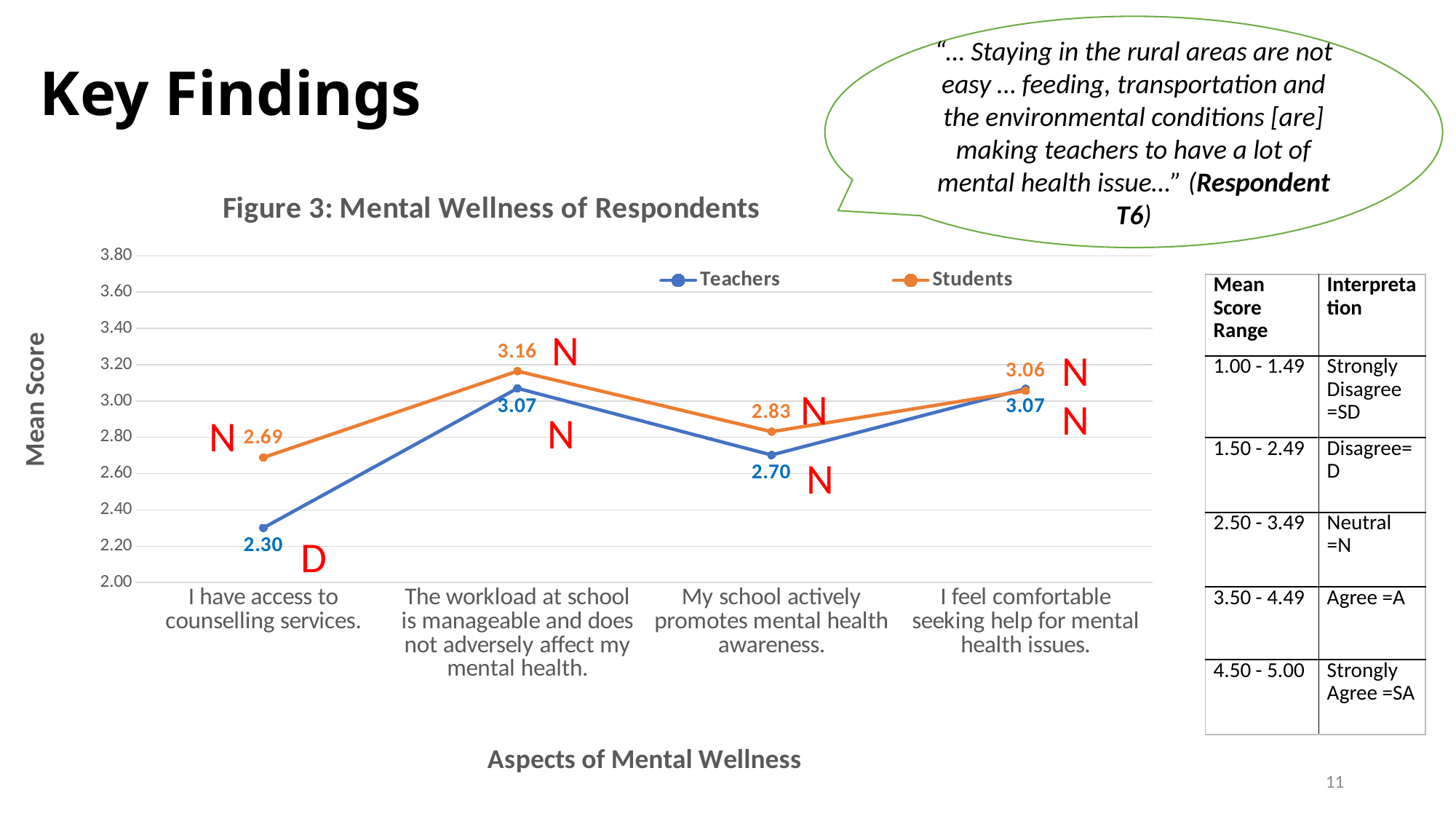
What is the Teachers mean score for "I feel comfortable seeking help for mental health issues."? 3.07 What is the Students mean score for "My school actively promotes mental health awareness."? 2.83 Is the Teachers mean score for "I have access to counselling services." greater or less than 2.40? less What is the Teachers mean score for "I have access to counselling services."? 2.30 What type of chart is Figure 3? Line chart How many aspects of mental wellness are shown on the x axis? 4 Which aspect has the lowest Teachers mean score? I have access to counselling services. For "My school actively promotes mental health awareness.", which series has the higher mean score, Teachers or Students? Students Which aspect has the highest Students mean score? The workload at school is manageable and does not adversely affect my mental health. What is the difference between the Students and Teachers mean scores for "I have access to counselling services."? 0.39 How many series does the legend list? 2 What is the Students mean score for "The workload at school is manageable and does not adversely affect my mental health."? 3.16